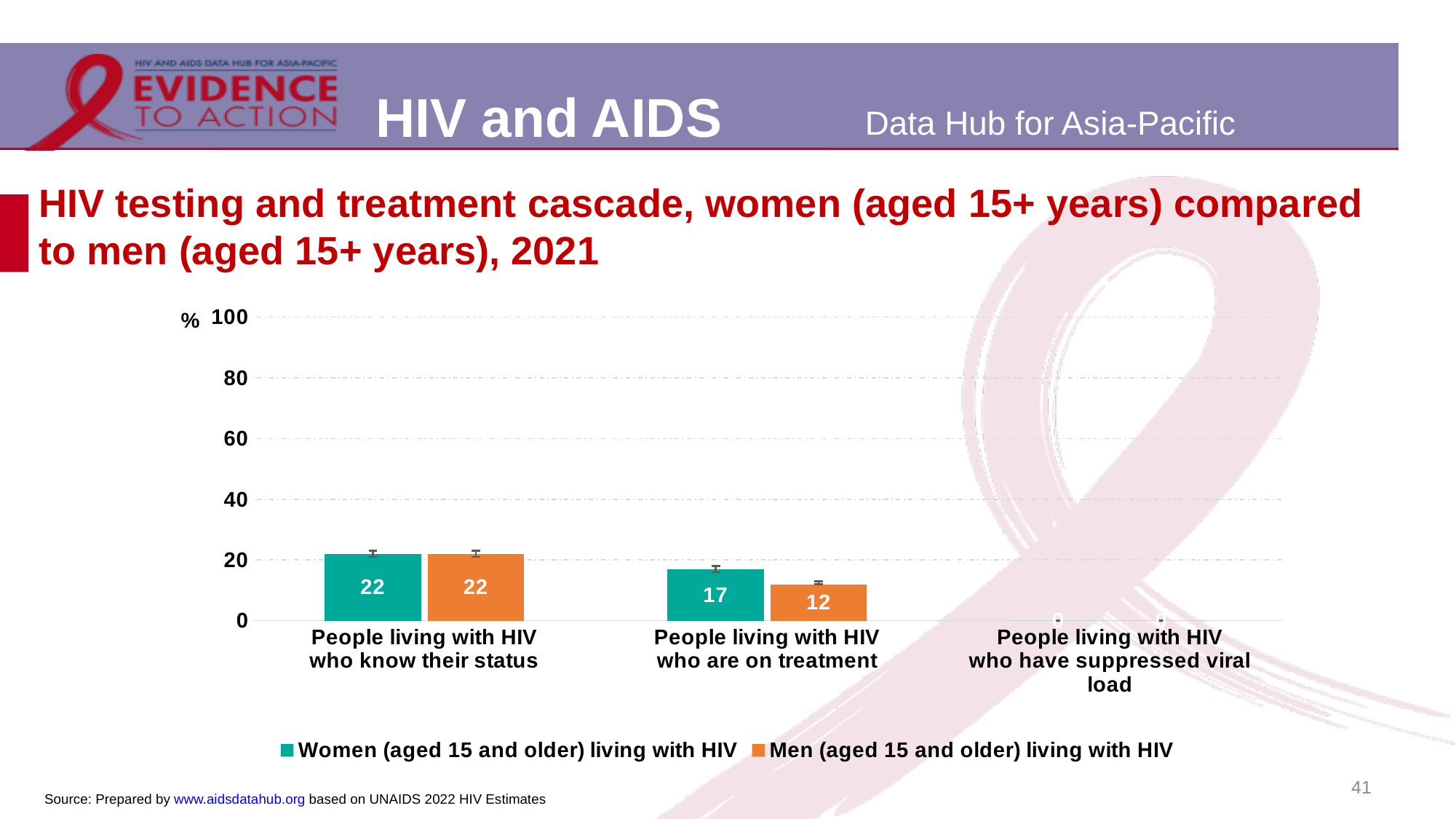
What is the difference between the women and men values for people living with HIV who are on treatment? 5 How many series does the legend list? 2 What is the value for men (aged 15 and older) living with HIV who know their status? 22 For people living with HIV who are on treatment, which series has the larger value, women or men? Women (aged 15 and older) living with HIV What colour are the bars for men (aged 15 and older) living with HIV? Orange What is the value for women (aged 15 and older) living with HIV who know their status? 22 Is the value for women living with HIV who are on treatment greater or less than 20? less How many categories are shown on the x axis? 3 Do the values for women fall or rise from 'know their status' to 'on treatment'? fall What is the value for women (aged 15 and older) living with HIV who are on treatment? 17 What kind of chart is shown on the slide? Bar chart What is the value for men (aged 15 and older) living with HIV who are on treatment? 12